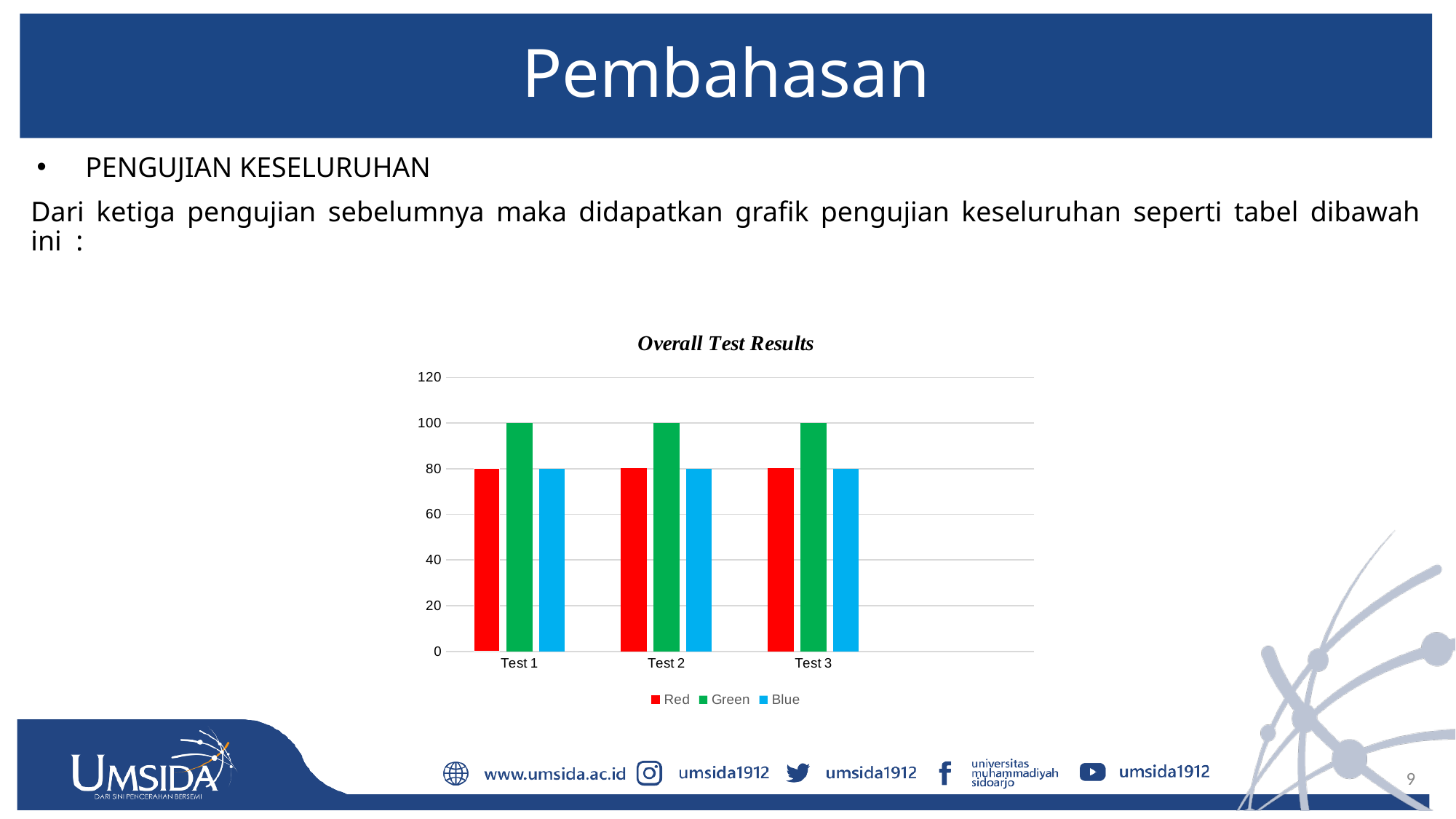
Is the Green value for Test 1 larger or smaller than the Blue value for Test 1? larger What is the value of the Red series for Test 1? 80 What is the difference between the Green and Red values for Test 3? 20 What is the value of the Green series for Test 2? 100 Is the value of the Red series for Test 2 greater or less than 100? less How many series does the chart legend list? 3 How many test categories are shown on the x axis of the chart? 3 Which series has the highest value for Test 1? Green What is the value of the Blue series for Test 3? 80 Do the Green series values rise, fall, or stay the same from Test 1 to Test 3? stay the same What is the title of the chart? Overall Test Results What kind of chart is shown on the slide? bar chart